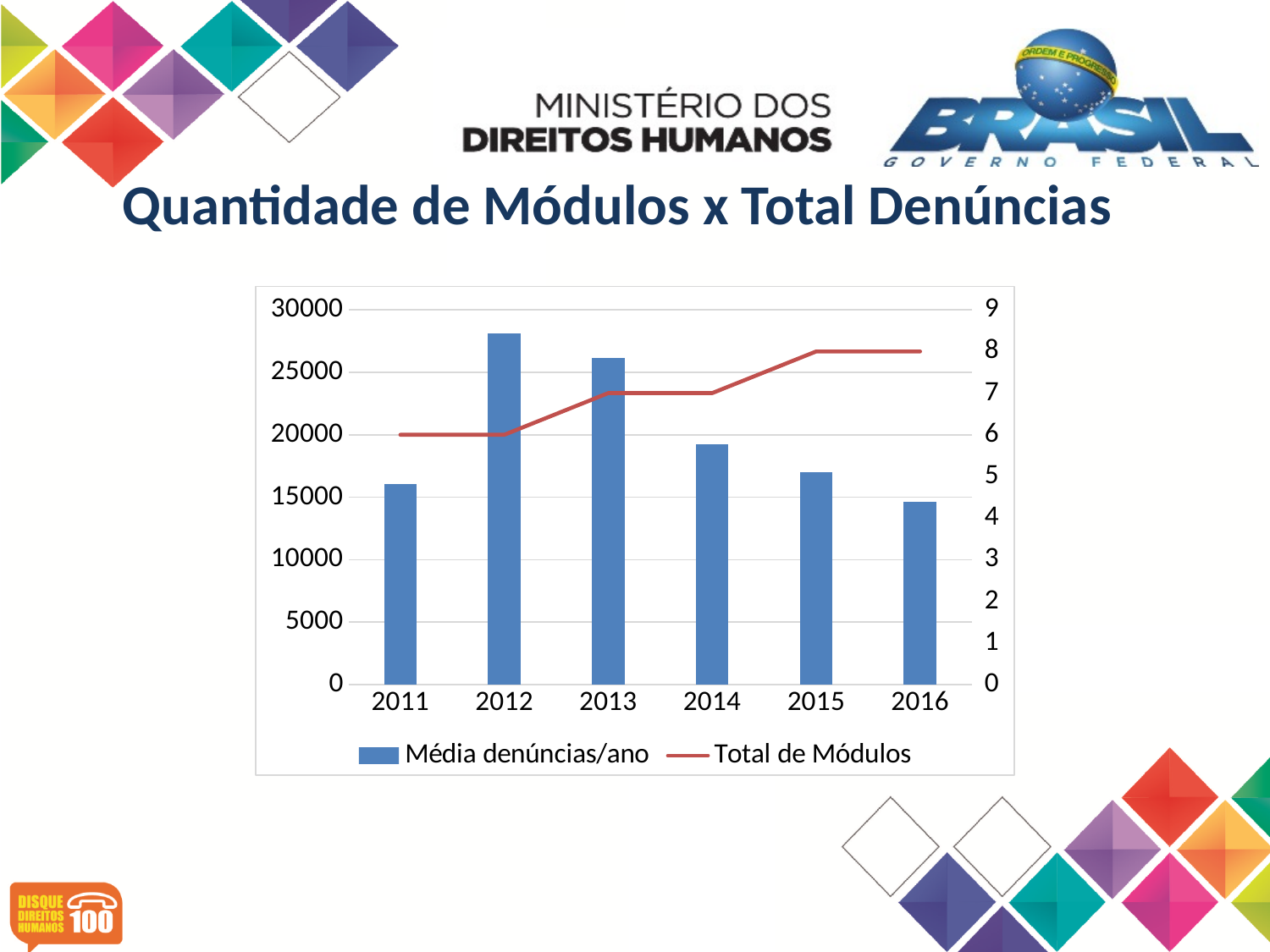
What is the value of Total de Módulos in 2016? 8 How many years are shown on the x axis of the chart? 6 By how much did Total de Módulos increase from 2011 to 2016? 2 Is the value for Média denúncias/ano in 2016 greater or less than 15000? less How many series does the chart legend list? 2 Which year has the lowest bar for Média denúncias/ano? 2016 Is the value for Média denúncias/ano in 2012 greater or less than 25000? greater What is the title of the chart on the slide? Quantidade de Módulos x Total Denúncias What is the value of Total de Módulos in 2011? 6 Which year has the highest bar for Média denúncias/ano? 2012 Which is larger, the Média denúncias/ano bar for 2013 or for 2014? 2013 What is the value of Total de Módulos in 2013? 7